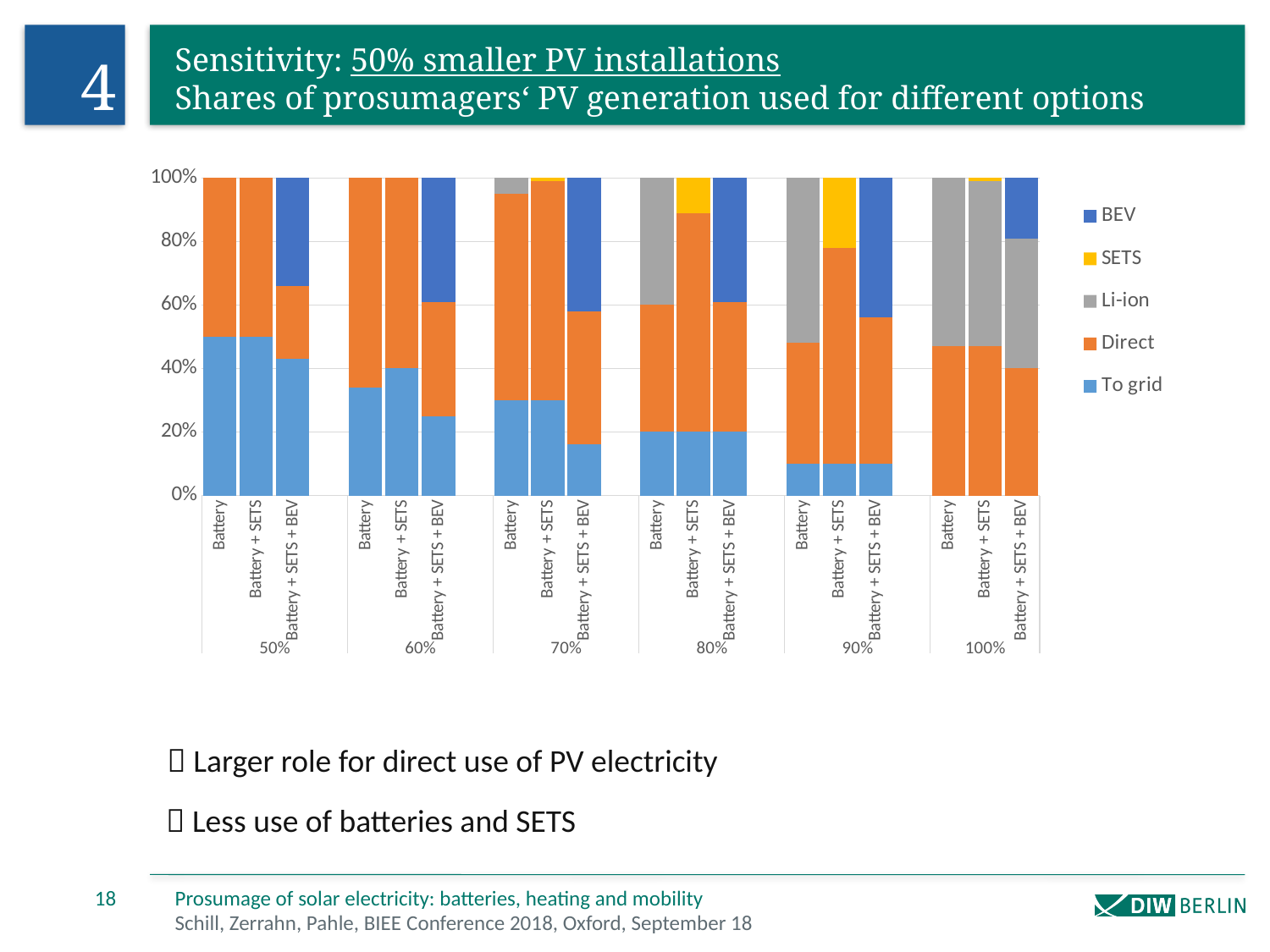
How many series does the legend list? 5 Which is larger: the 'To grid' share for the Battery bar in the 50% group or in the 80% group? 50% group Which colour represents 'Direct' in the legend? Orange Does the 'To grid' share for the Battery bars rise or fall as the groups go from 50% to 100%? fall Is the 'To grid' share for the Battery bar in the 60% group greater or less than 20%? greater Is the 'To grid' share for the Battery bar in the 90% group greater or less than 20%? less How many bars are there in each percentage group? 3 Is the 'To grid' share for the Battery + SETS + BEV bar in the 50% group greater or less than 40%? greater How many percentage groups (50% to 100%) are shown along the x axis? 6 What kind of chart is shown on the slide? Stacked bar chart Which series is shown in yellow in the legend? SETS In which percentage group is the 'To grid' share for the Battery bar the highest? 50%